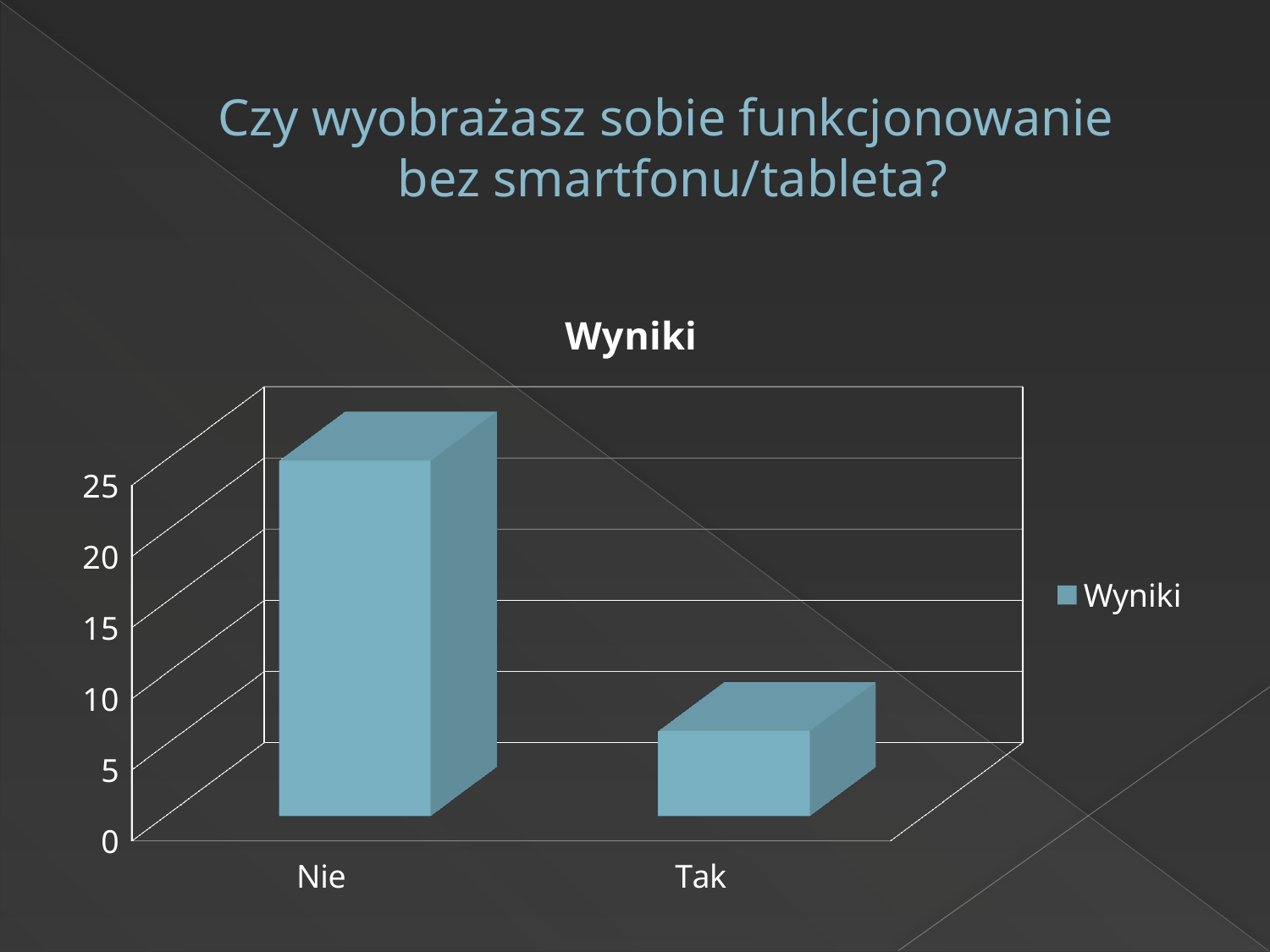
Is the value for Tak greater or less than 15? less Is the value for Tak greater or less than 10? less Which is larger, the value for Nie or the value for Tak? Nie How many categories are shown on the x axis of the chart? 2 Do the values rise or fall from Nie to Tak along the x axis? fall What is the title of the chart? Wyniki Which category has the highest value in the chart? Nie What is the name of the series listed in the legend? Wyniki Which category has the lowest value in the chart? Tak Is the value for Nie greater or less than 20? greater How many series does the chart legend list? 1 What kind of chart is shown on the slide? bar chart